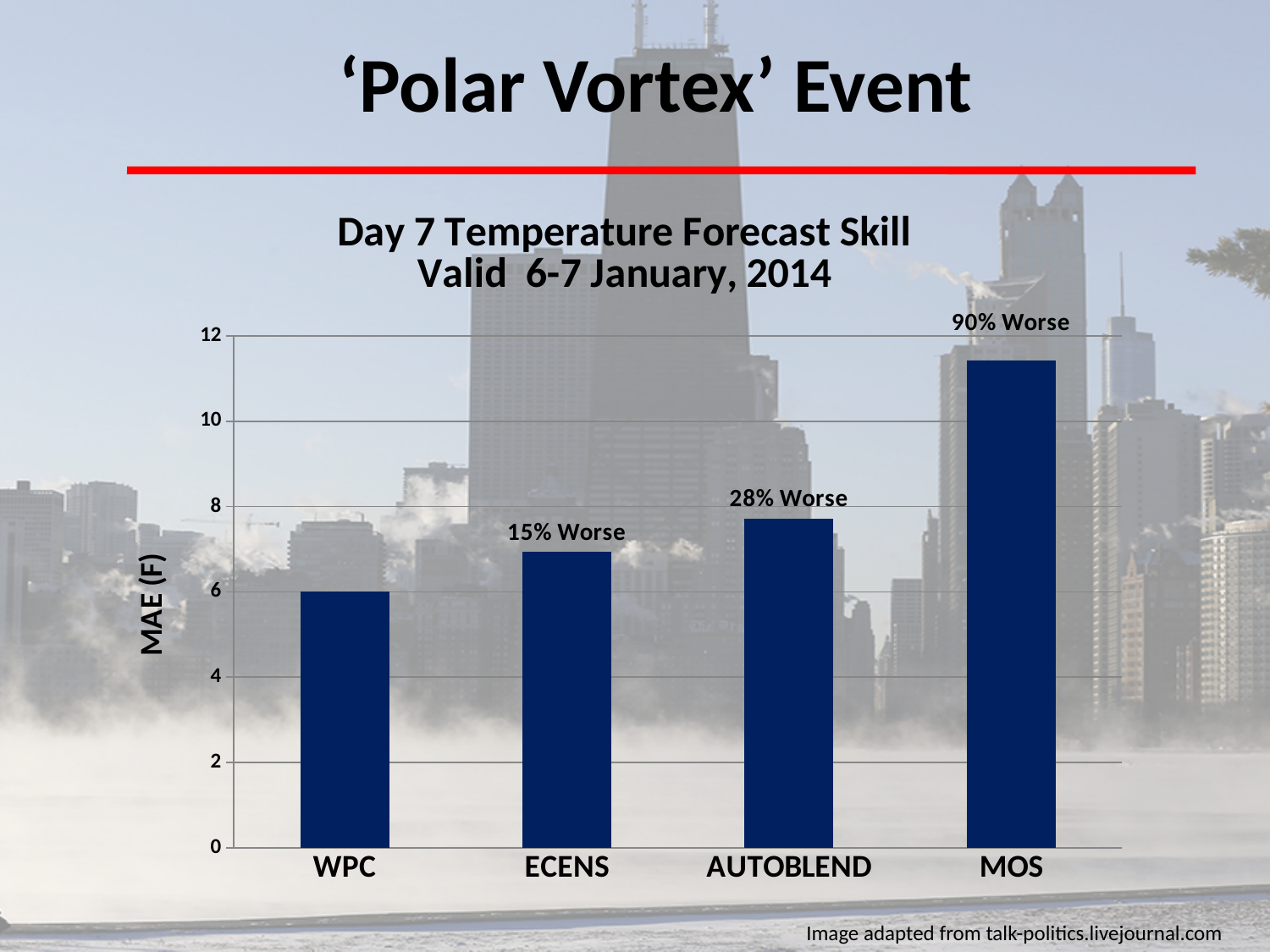
What is the label of the y axis of the chart? MAE (F) Do the MAE values rise or fall moving from WPC to MOS along the x axis? rise Which has a larger MAE, ECENS or AUTOBLEND? AUTOBLEND What label is printed above the MOS bar? 90% Worse What label is printed above the AUTOBLEND bar? 28% Worse How many categories are shown on the x axis of the chart? 4 Is the MAE value for AUTOBLEND greater or less than 8? less What type of chart is shown on the slide? bar chart Is the MAE value for MOS greater or less than 10? greater What label is printed above the ECENS bar? 15% Worse Which category has the lowest MAE in the chart? WPC Which category has the highest MAE in the chart? MOS